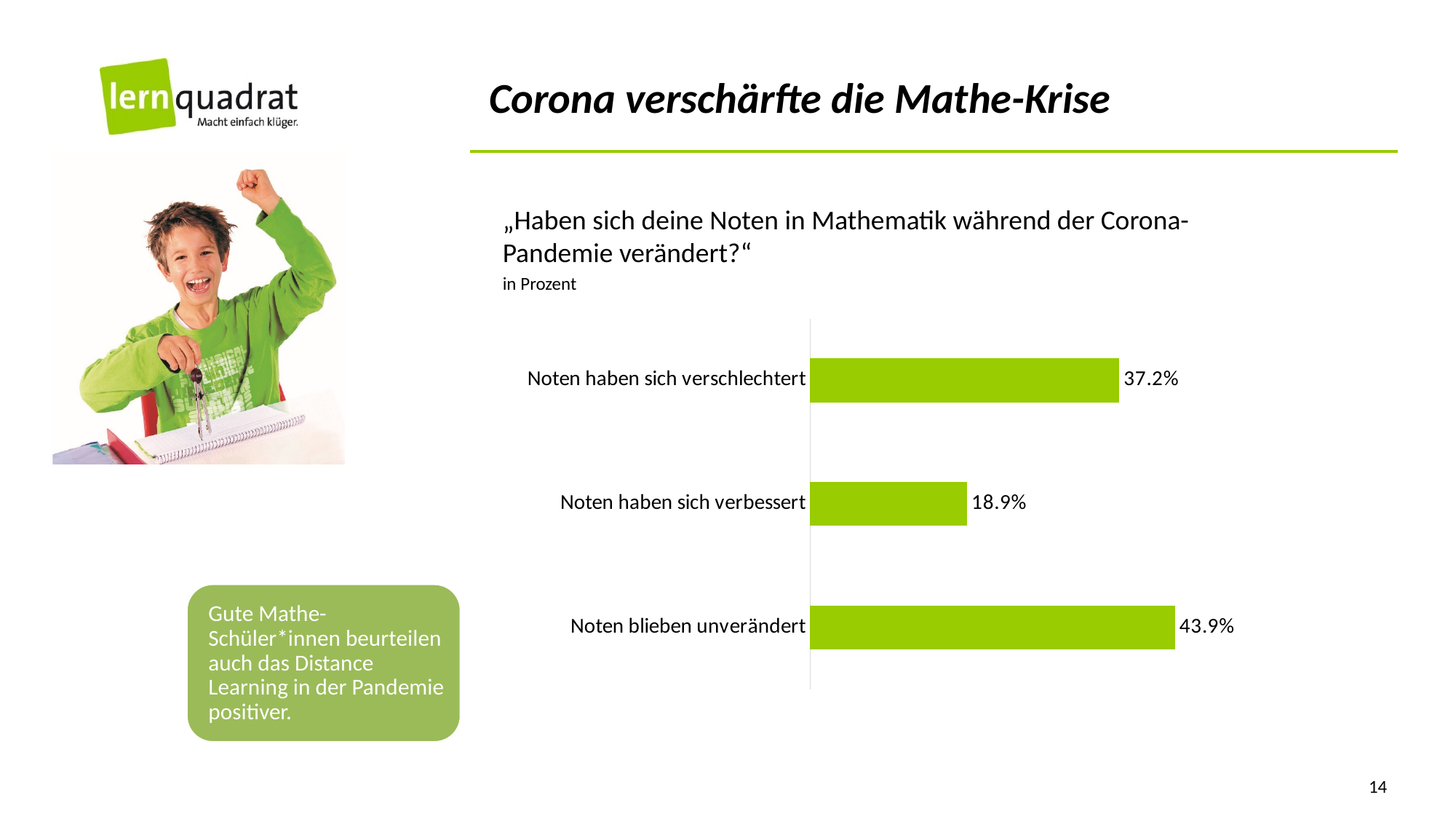
What is the value for "Noten haben sich verbessert"? 18.9% What is the difference between "Noten haben sich verschlechtert" and "Noten haben sich verbessert"? 18.3% What percentage of respondents said their maths grades got worse ("Noten haben sich verschlechtert")? 37.2% What is the value for "Noten blieben unverändert"? 43.9% What kind of chart is shown on the slide? Bar chart What is the total of the three values shown in the chart? 100% Which category has the lowest value? Noten haben sich verbessert What unit are the chart values given in, according to the note under the chart question? in Prozent Which is larger: the value for "Noten haben sich verschlechtert" or for "Noten haben sich verbessert"? Noten haben sich verschlechtert How many categories are shown in the chart? 3 Which category has the highest value? Noten blieben unverändert What is the difference between "Noten blieben unverändert" and "Noten haben sich verschlechtert"? 6.7%